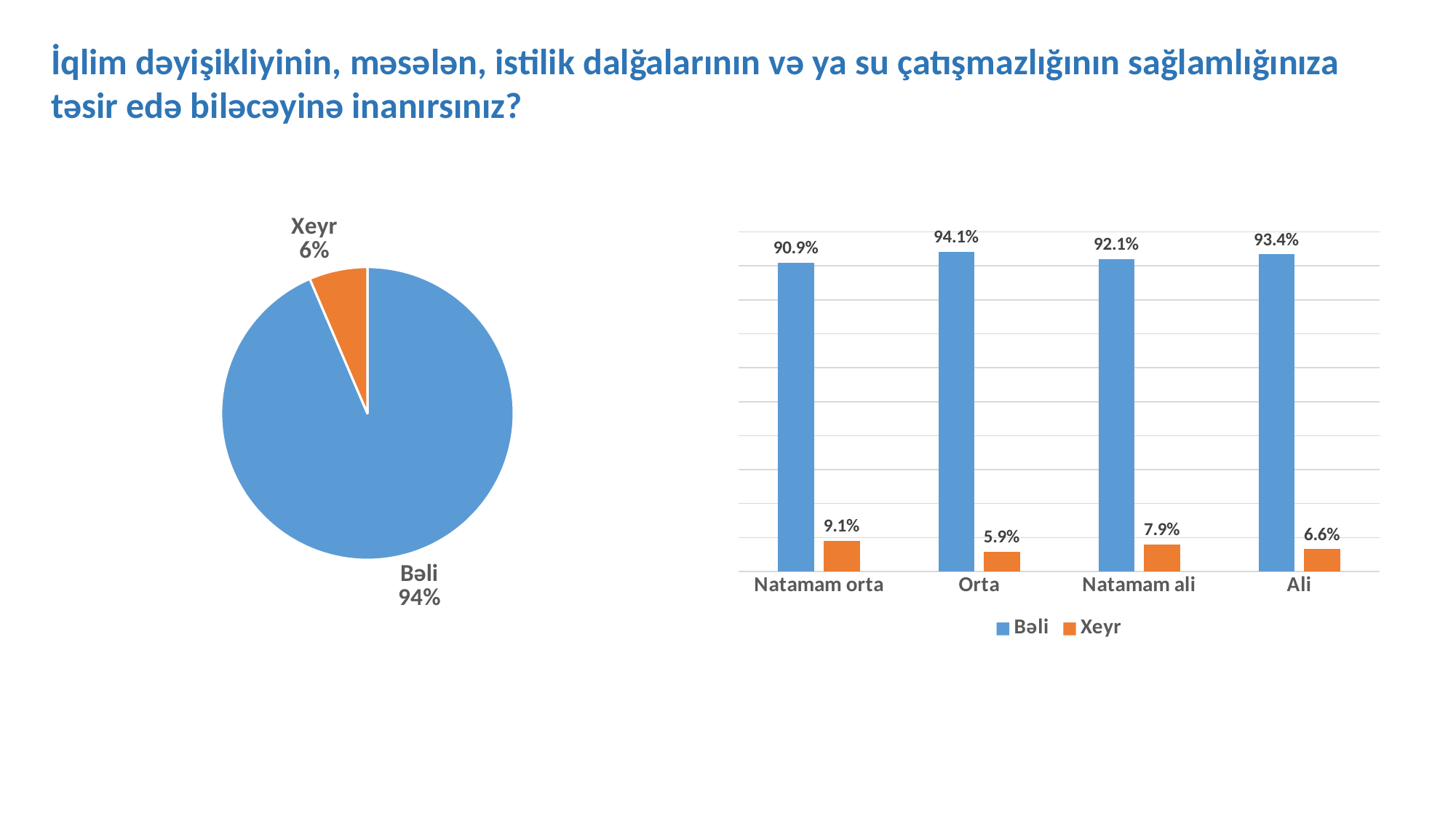
What kind of chart is the chart on the right of the slide? bar chart In the bar chart on the right, which category has the highest Bəli value? Orta In the bar chart on the right, which category has the lowest Xeyr value? Orta What kind of chart is the chart on the left of the slide? pie chart In the pie chart on the left, what share is labelled for Bəli? 94% In the bar chart on the right, which is larger: the Xeyr value for Natamam orta or for Ali? Natamam orta In the pie chart on the left, what share is labelled for Xeyr? 6% In the bar chart on the right, what is the Xeyr value for Natamam ali? 7.9% In the bar chart on the right, what is the difference between the Bəli values for Ali and Natamam orta? 2.5% How many categories are shown on the x axis of the bar chart on the right? 4 In the bar chart on the right, what is the Bəli value for Orta? 94.1% How many series does the legend of the bar chart on the right list? 2